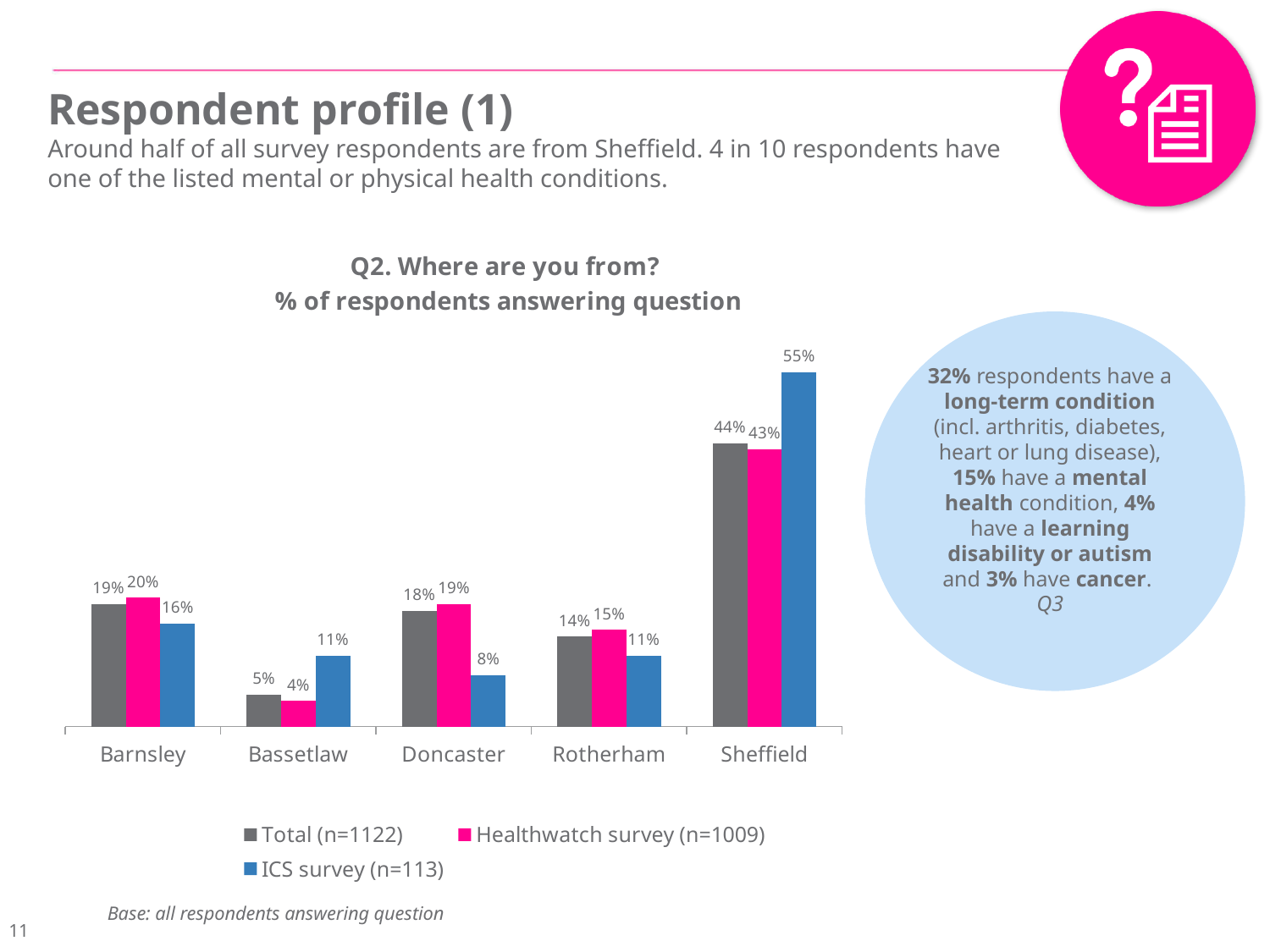
What is the difference between the ICS survey (n=113) and Healthwatch survey (n=1009) values for Sheffield? 12% Which is larger for Doncaster: the Total (n=1122) value or the ICS survey (n=113) value? Total (n=1122) How many areas are shown on the x axis? 5 What is the title of the chart? Q2. Where are you from? What is the Healthwatch survey (n=1009) value for Rotherham? 15% How many series does the legend list? 3 What is the ICS survey (n=113) value for Bassetlaw? 11% Which area has the highest ICS survey (n=113) value? Sheffield What kind of chart is shown? Bar chart Which area has the lowest Healthwatch survey (n=1009) value? Bassetlaw Which colour represents the Healthwatch survey (n=1009) series? Pink What is the Total (n=1122) value for Sheffield? 44%